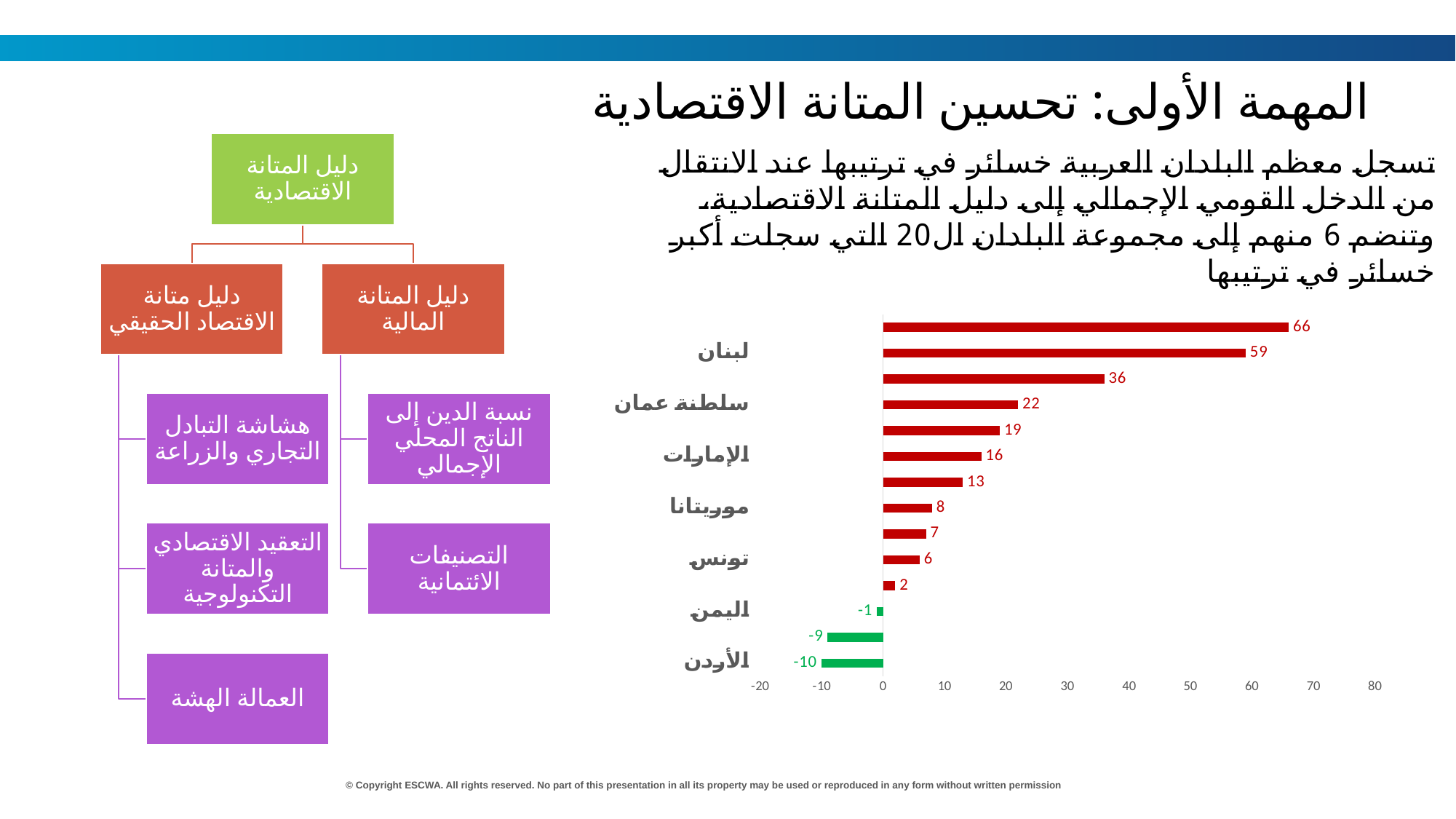
What is the value of the bar labelled لبنان? 59 How many bars are plotted in the chart? 14 What is the difference between the values for لبنان and سلطنة عمان? 37 What is the value of the bar labelled سلطنة عمان? 22 Which is larger, the value for الإمارات or the value for تونس? الإمارات What is the value of the bar labelled الأردن? -10 What is the highest value shown in the chart? 66 Is the value for لبنان greater or less than 50? greater How many bars in the chart have negative values? 3 What kind of chart is shown on the slide? bar chart What is the value of the bar labelled اليمن? -1 What is the lowest value shown in the chart? -10